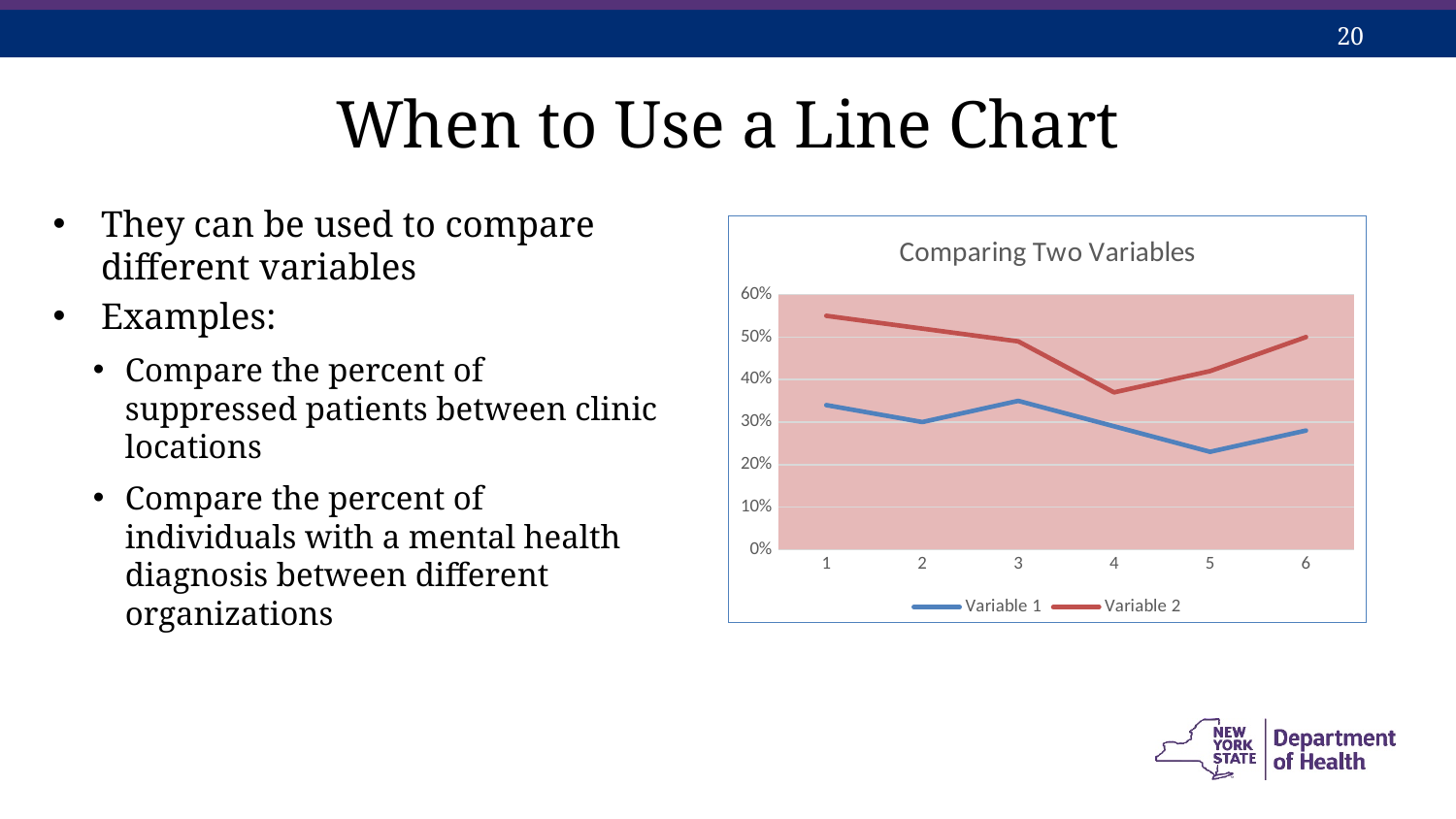
How many points are plotted along the x axis for each series? 6 What kind of chart is shown on the slide? line chart What is the title of the chart? Comparing Two Variables At which x value does Variable 2 reach its highest point? 1 What are the names of the two series in the legend? Variable 1 and Variable 2 At which x value does Variable 1 reach its lowest point? 5 How many series does the legend list? 2 Is the value of Variable 2 at x = 1 greater or less than 50%? greater At x = 1, which series has the larger value, Variable 1 or Variable 2? Variable 2 Does Variable 2 rise or fall from x = 1 to x = 4? fall Is the value of Variable 1 at x = 5 greater or less than 30%? less Is the value of Variable 2 at x = 4 greater or less than 30%? greater